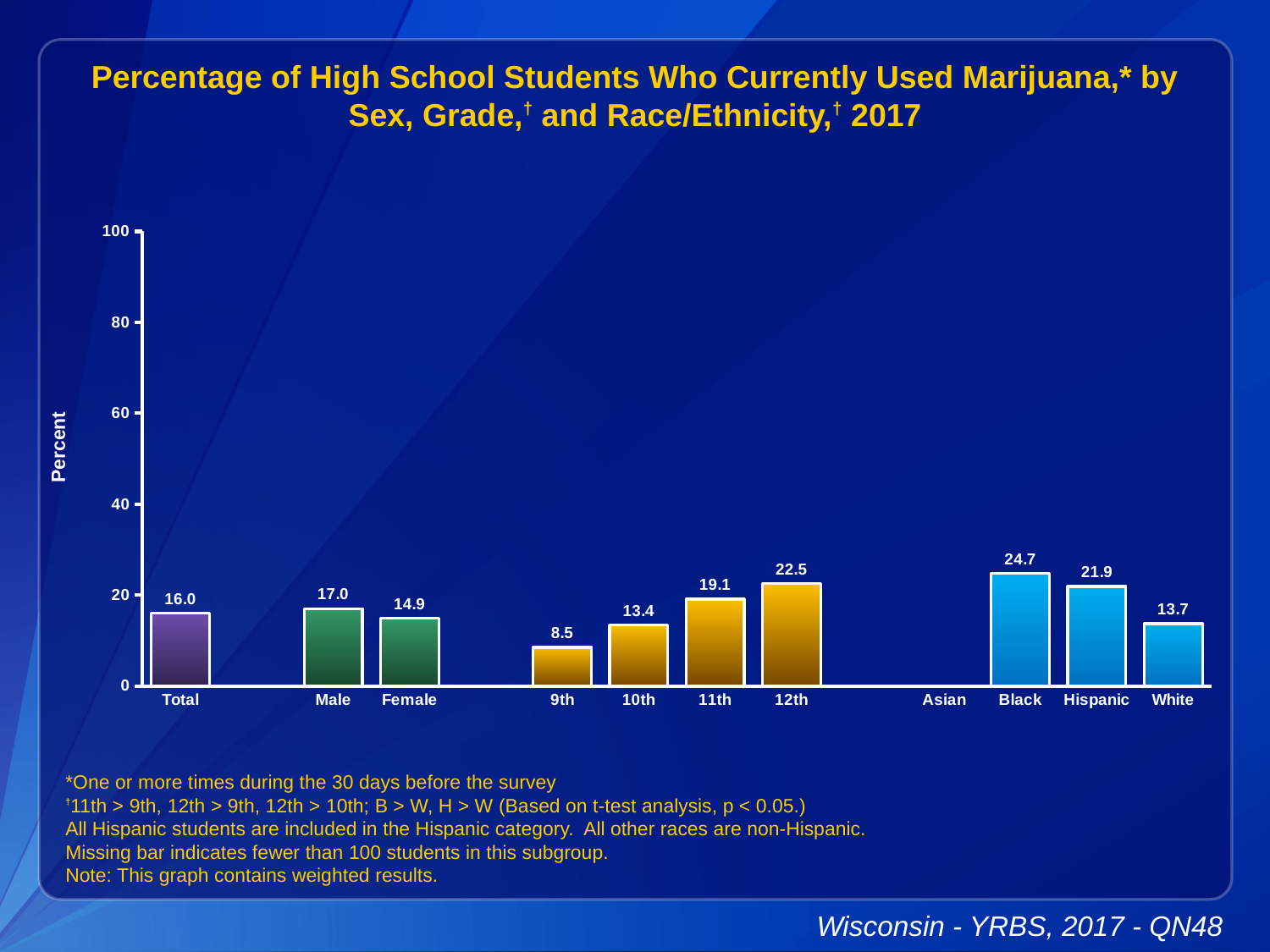
What is the value for Hispanic? 21.9 Do the values rise or fall from 9th grade to 12th grade? rise What is the difference between the values for 12th and 9th grade? 14.0 What kind of chart is shown on the slide? bar chart Which category label has no bar shown? Asian Which category has the lowest value among the bars shown? 9th What is the difference between the values for Male and Female? 2.1 Which category has the highest value? Black What is the value for Female? 14.9 What is the value for Total? 16.0 What is the value for 9th grade? 8.5 Which is larger, the value for Black or the value for White? Black